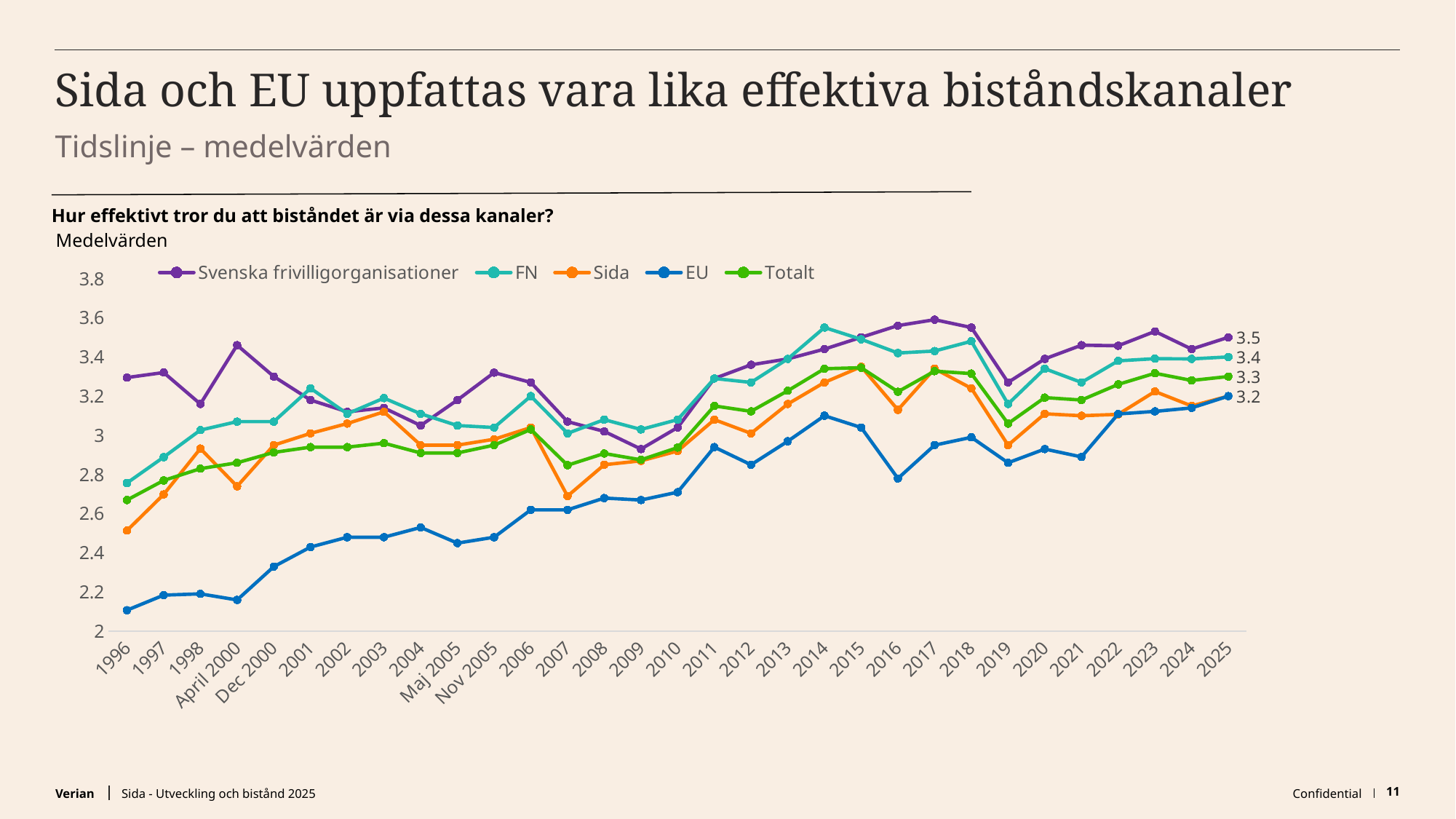
Does the EU series generally rise or fall from 1996 to 2025? Rise What is the value for Svenska frivilligorganisationer in 2025? 3.5 What is the difference between Svenska frivilligorganisationer and FN in 2025? 0.1 What is the value for FN in 2025? 3.4 Is the value for EU in 1996 greater or less than 2.2? less How many series does the legend list? 5 Which series has the highest value in 2025? Svenska frivilligorganisationer What is the value for Totalt in 2025? 3.3 Which series has the lowest value in 1996? EU Is the value for Svenska frivilligorganisationer in 2017 greater or less than 3.4? greater What type of chart is shown on the slide? Line chart How many time points are shown on the x axis? 31